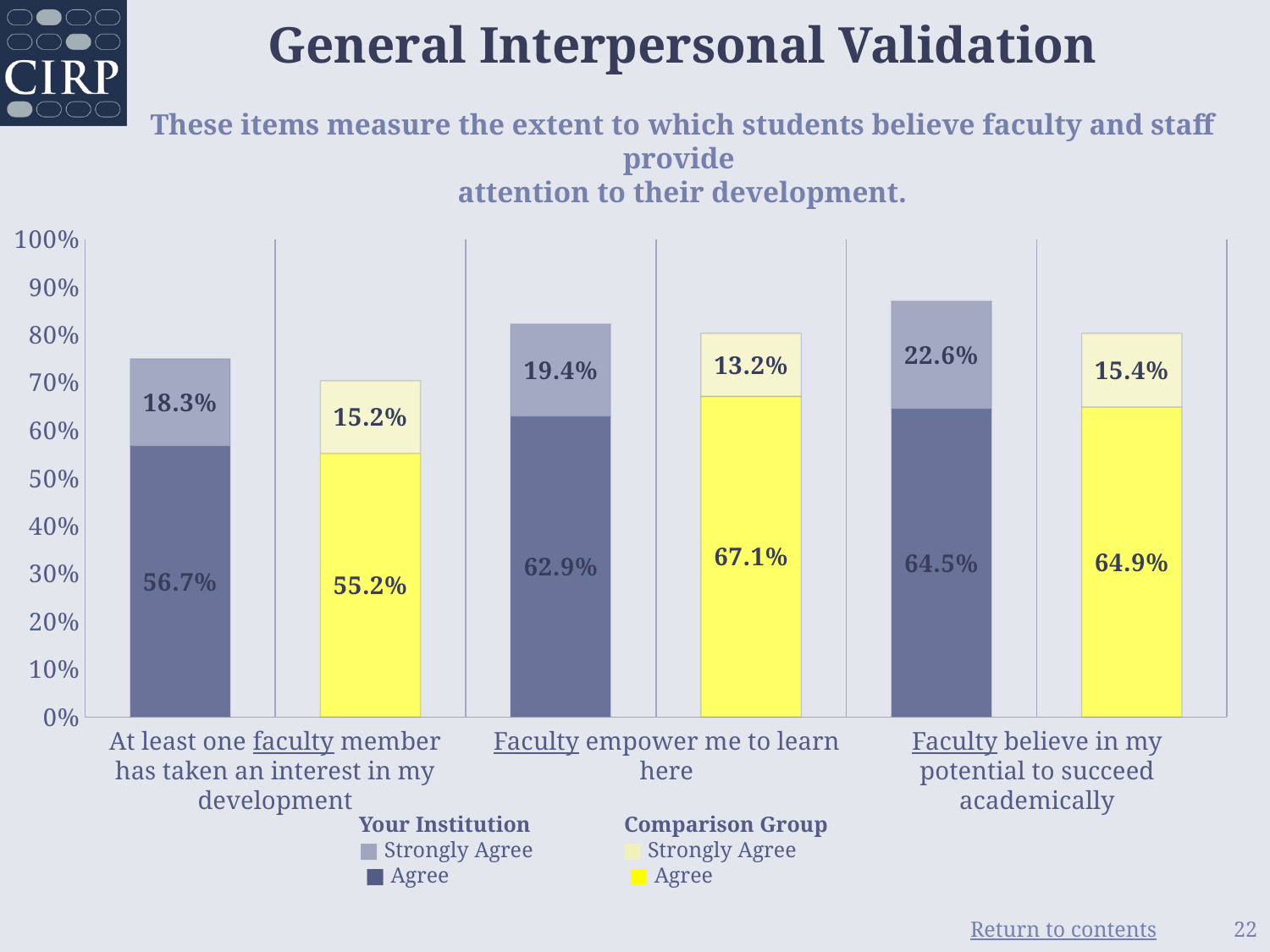
For 'Faculty empower me to learn here', which is larger: the Your Institution 'Agree' value or the Comparison Group 'Agree' value? Comparison Group What is the Comparison Group 'Agree' value for 'Faculty believe in my potential to succeed academically'? 64.9% Which item has the lowest Comparison Group 'Agree' value? At least one faculty member has taken an interest in my development What is the total (Agree plus Strongly Agree) for the Your Institution bar for 'At least one faculty member has taken an interest in my development'? 75.0% How many items (categories) are shown on the x axis of the chart? 3 What is the Your Institution 'Strongly Agree' value for 'Faculty believe in my potential to succeed academically'? 22.6% Is the total height of the Your Institution bar for 'Faculty believe in my potential to succeed academically' greater or less than 80%? greater What percentage of Your Institution students 'Agree' that at least one faculty member has taken an interest in their development? 56.7% What is the Comparison Group 'Strongly Agree' value for 'Faculty empower me to learn here'? 13.2% What is the difference between the Your Institution and Comparison Group 'Strongly Agree' values for 'Faculty believe in my potential to succeed academically'? 7.2% Which item has the highest Your Institution 'Strongly Agree' value? Faculty believe in my potential to succeed academically How many series does the legend list? 4